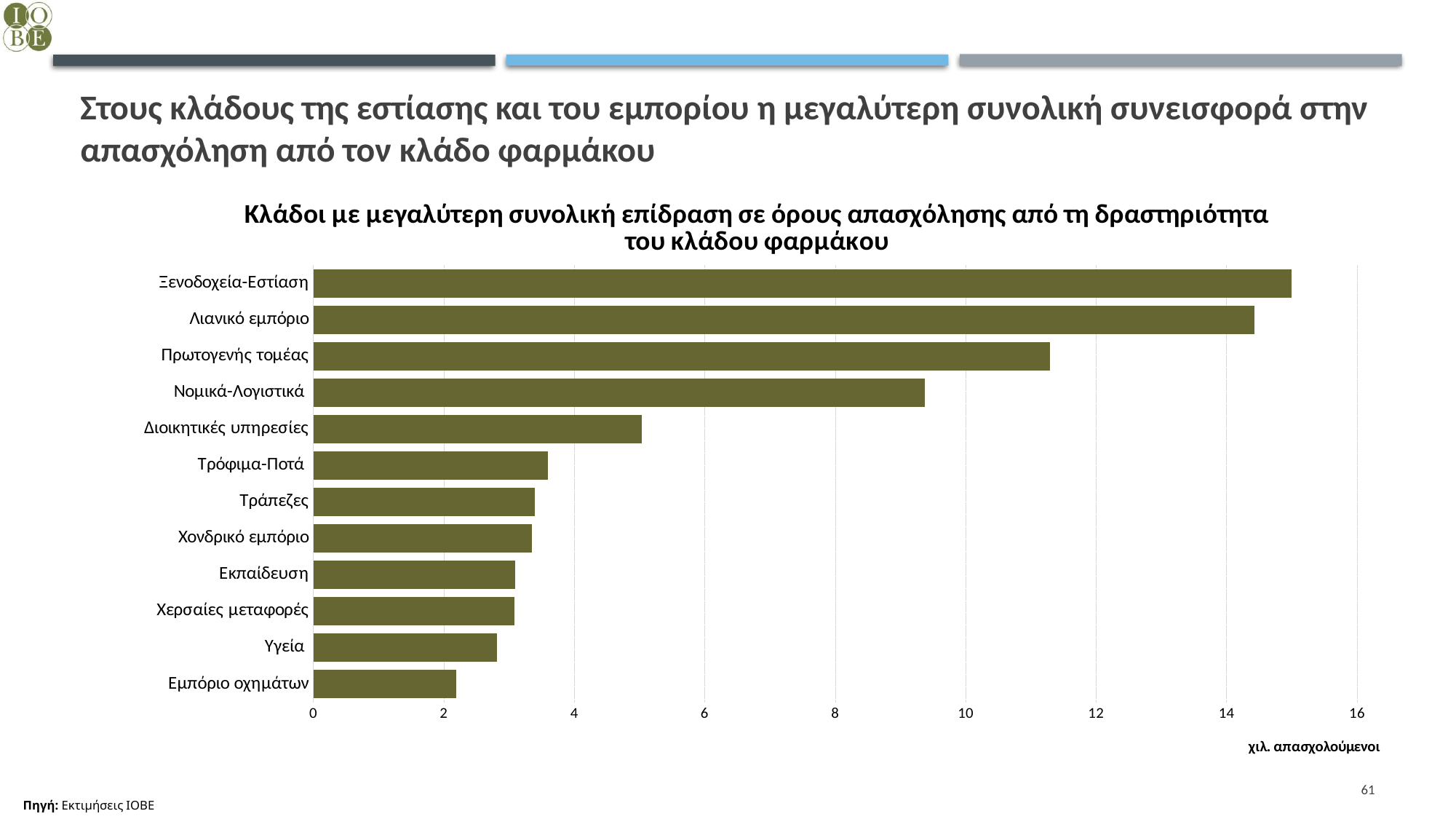
Is the value for Διοικητικές υπηρεσίες greater or less than 6? less Which is larger, the value for Λιανικό εμπόριο or the value for Πρωτογενής τομέας? Λιανικό εμπόριο Is the value for Πρωτογενής τομέας greater or less than 12? less What unit is indicated below the x axis of the chart? χιλ. απασχολούμενοι Is the value for Νομικά-Λογιστικά greater or less than 8? greater Which sector has the lowest value in the chart? Εμπόριο οχημάτων Which is larger, the value for Υγεία or the value for Τρόφιμα-Ποτά? Τρόφιμα-Ποτά Which sector has the highest value in the chart? Ξενοδοχεία-Εστίαση How many sectors (categories) are plotted in the chart? 12 What kind of chart is shown on the slide? Bar chart